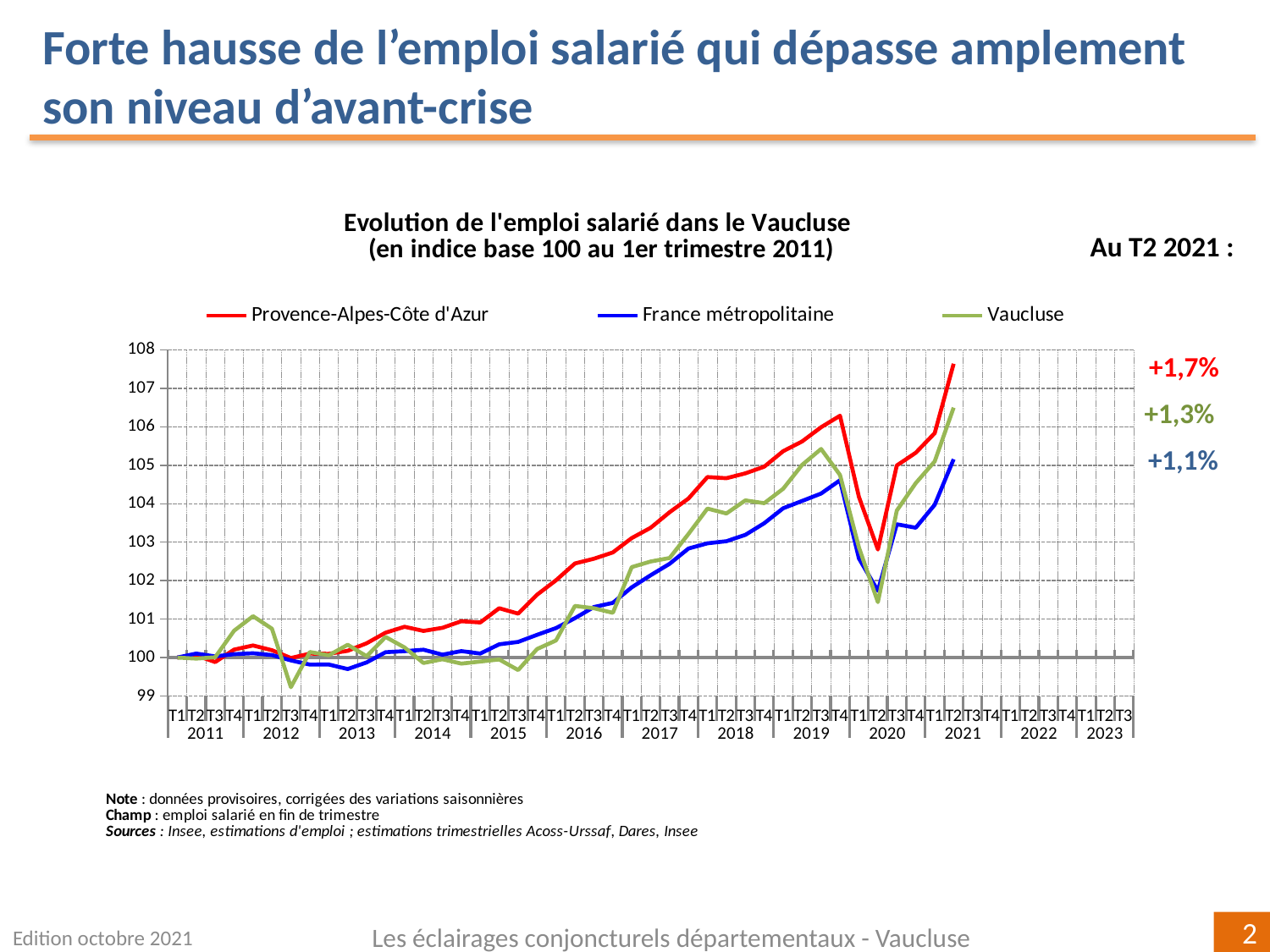
How many series does the legend list? 3 Is the value for Vaucluse at T2 2020 greater or less than 102? less What kind of chart is shown on the slide? line chart Which series has the highest value at T2 2021? Provence-Alpes-Côte d'Azur What growth rate is shown for Provence-Alpes-Côte d'Azur at T2 2021? +1,7% What growth rate is shown for France métropolitaine at T2 2021? +1,1% Does the Provence-Alpes-Côte d'Azur series rise or fall between T1 2015 and T4 2019? rise What is the title of the chart? Evolution de l'emploi salarié dans le Vaucluse (en indice base 100 au 1er trimestre 2011) Is the value for Provence-Alpes-Côte d'Azur at T2 2021 greater or less than 107? greater What growth rate is shown for Vaucluse at T2 2021? +1,3% Which series has the lowest value at T2 2021? France métropolitaine Is the value for Vaucluse at T3 2012 greater or less than 100? less